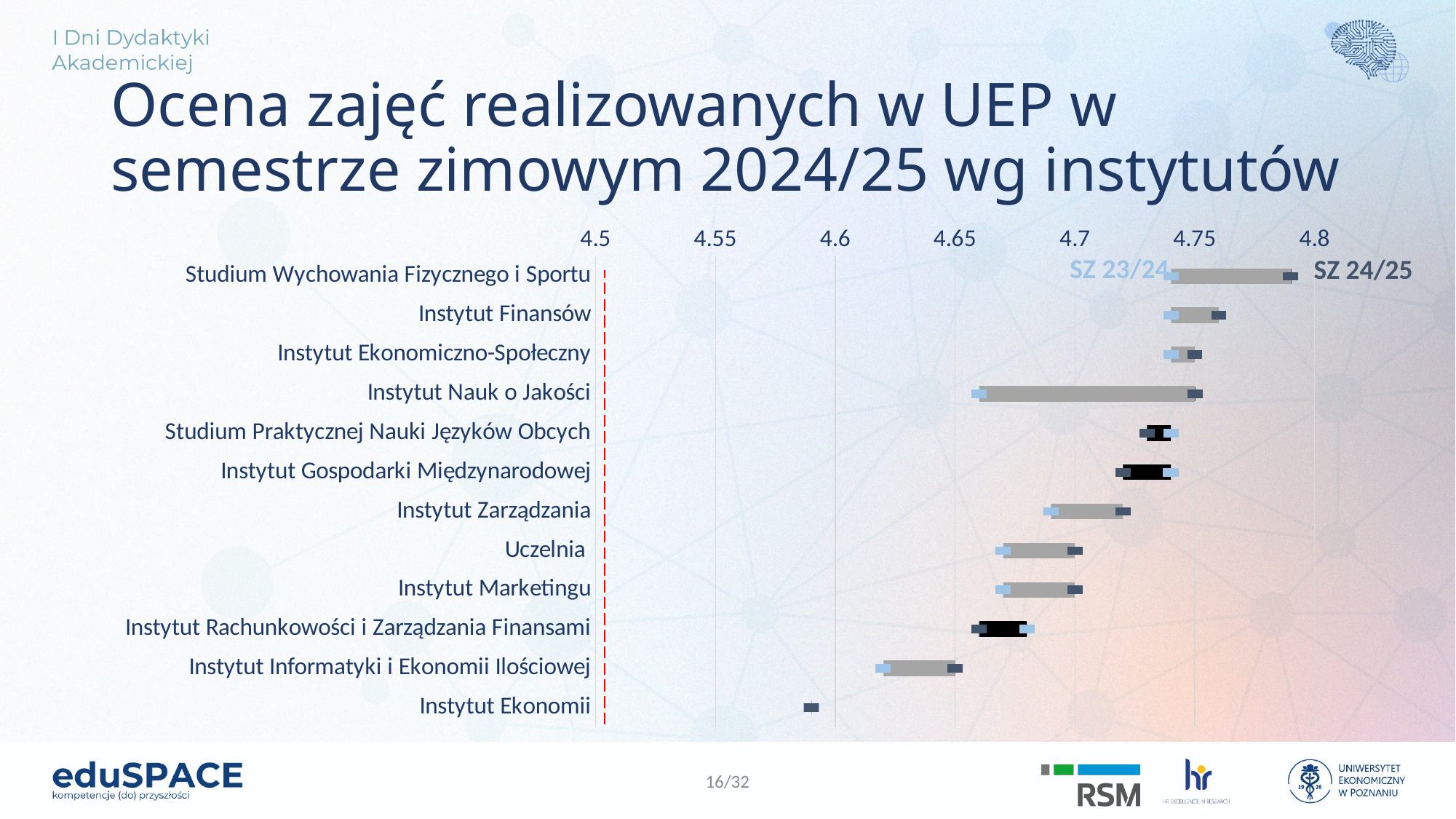
Which has the larger SZ 24/25 value, Instytut Finansów or Instytut Marketingu? Instytut Finansów Is the SZ 24/25 value for Instytut Ekonomii greater or less than 4.6? less How many institutes/units are listed on the vertical axis of the chart? 12 What are the two series labels shown on the chart? SZ 23/24 and SZ 24/25 Is the SZ 23/24 value for Instytut Informatyki i Ekonomii Ilościowej greater or less than 4.6? greater Which unit has the highest SZ 24/25 value? Studium Wychowania Fizycznego i Sportu How many series does the chart show (as labelled in the legend)? 2 At what axis value is the red dashed vertical line drawn? 4.5 Is the SZ 24/25 value for Instytut Zarządzania greater or less than 4.7? greater Which unit has the lowest SZ 24/25 value? Instytut Ekonomii